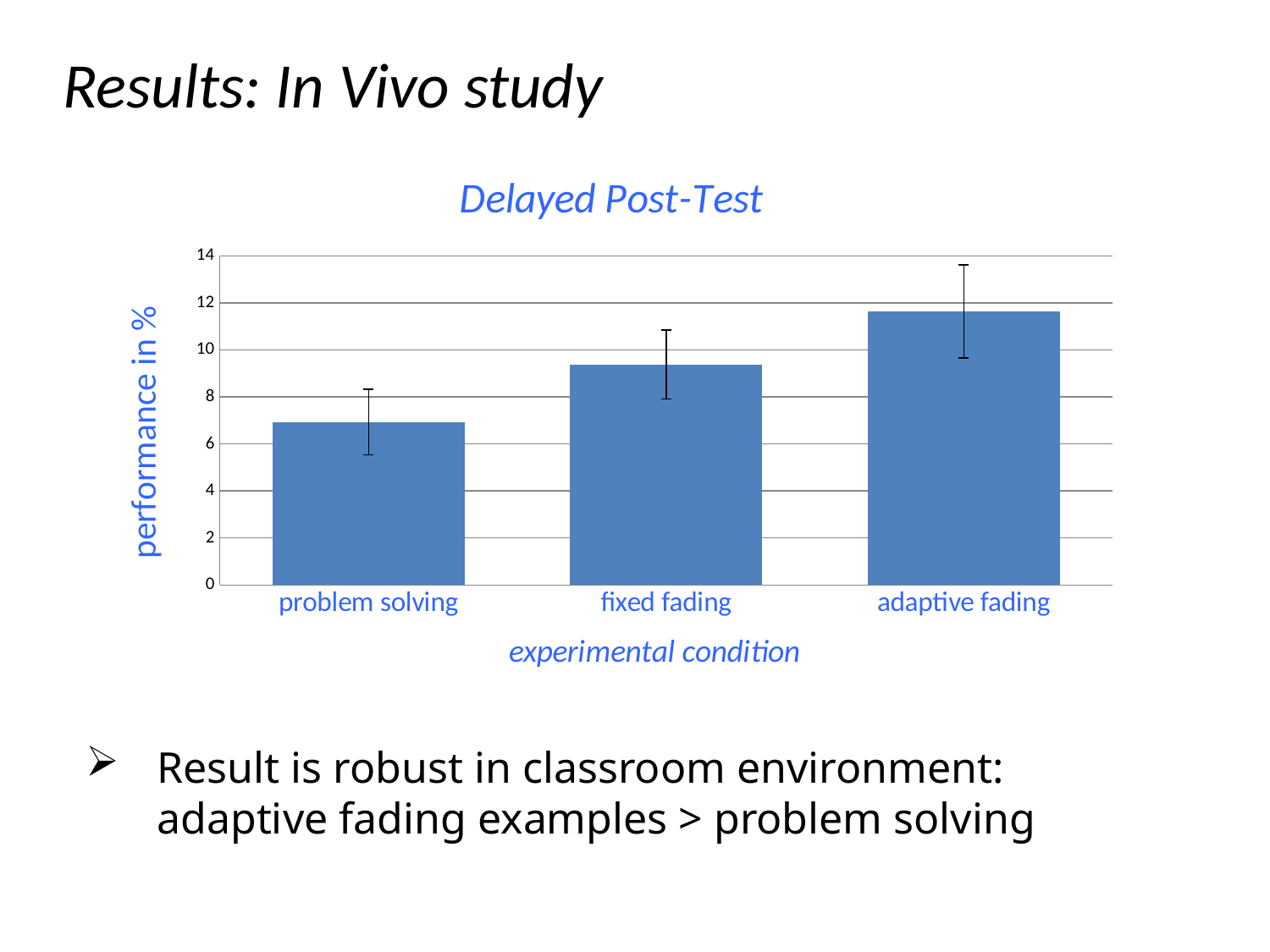
Which has a higher performance, fixed fading or problem solving? fixed fading Which experimental condition has the highest performance? adaptive fading Do the bar values rise or fall from left to right across the experimental conditions? rise How many experimental conditions are plotted in the chart? 3 Which experimental condition has the lowest performance? problem solving What type of chart is shown on the slide? bar chart Is the value for problem solving greater or less than 8? less Is the value for fixed fading greater or less than 8? greater What is the title of the chart? Delayed Post-Test Is the value for adaptive fading greater or less than 10? greater What is the label of the y axis? performance in %